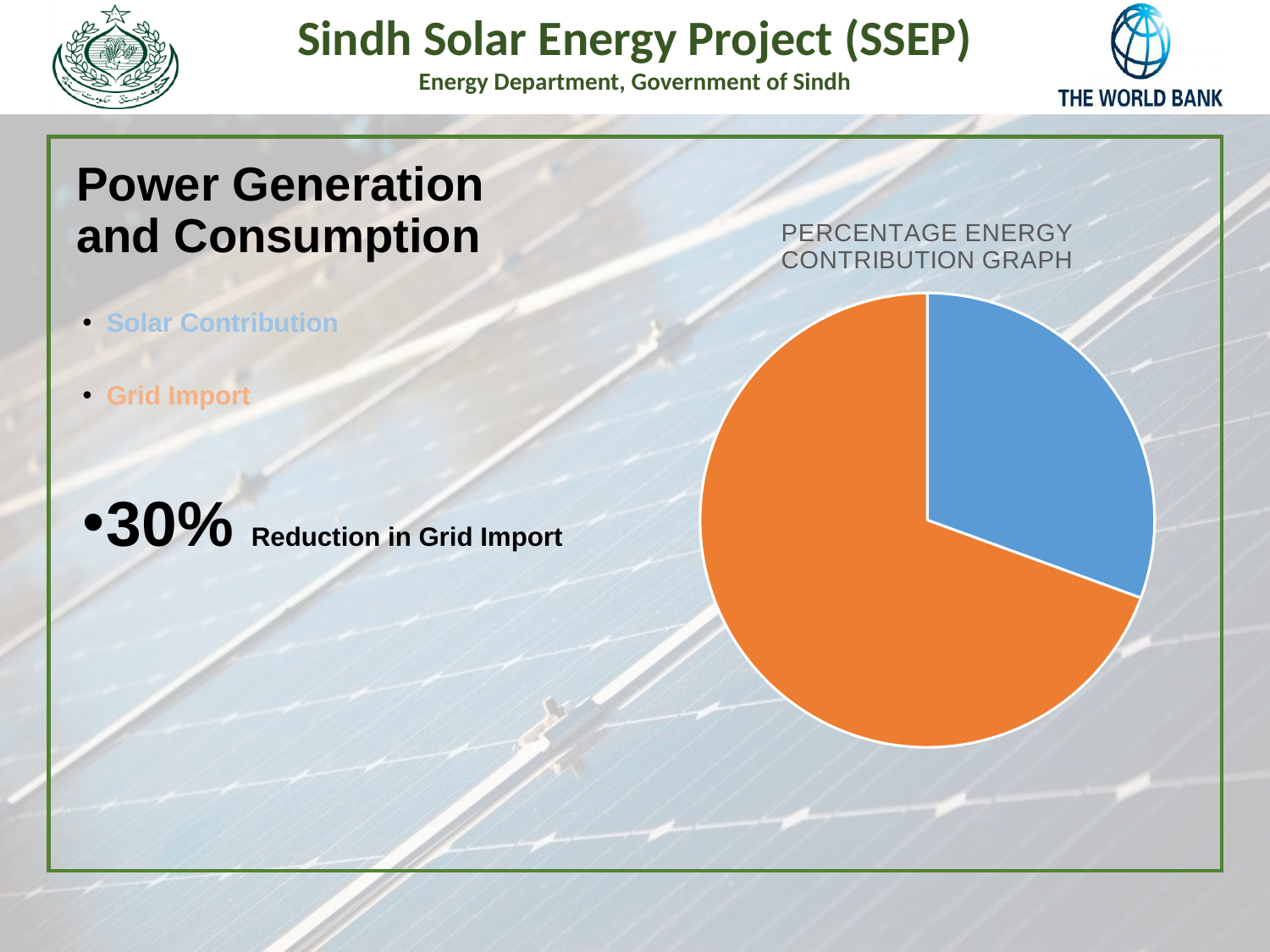
Which is larger in the pie chart, Solar Contribution or Grid Import? Grid Import Which category has the largest slice in the pie chart? Grid Import What colour represents Solar Contribution in the pie chart? Blue What kind of chart is shown on the slide? Pie chart Does the Grid Import slice take up more or less than half of the pie chart? More What is the title of the chart on the slide? PERCENTAGE ENERGY CONTRIBUTION GRAPH Which category has the smallest slice in the pie chart? Solar Contribution How many slices does the pie chart have? 2